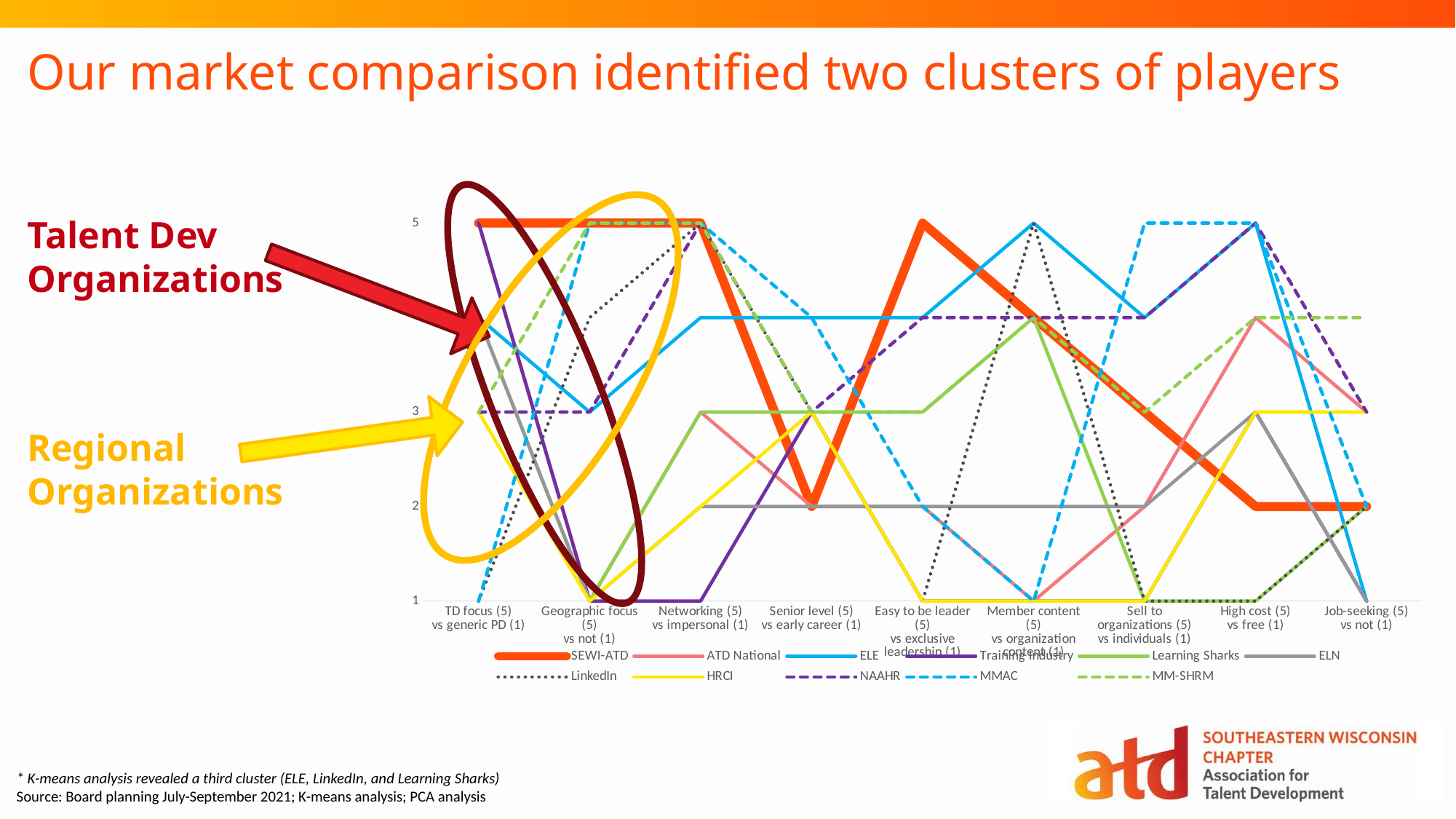
How many series does the chart legend list? 11 What is the value for ELE at 'Job-seeking (5) vs not (1)'? 1 Which series is drawn with the thick orange line in the chart? SEWI-ATD What is the difference between the SEWI-ATD value at 'Easy to be leader (5) vs exclusive leadership (1)' and its value at 'Senior level (5) vs early career (1)'? 3 What kind of chart is shown on the slide? line chart What is the value for ELE at 'Member content (5) vs organization content (1)'? 5 What is the title of the slide containing the chart? Our market comparison identified two clusters of players How many categories are shown along the x axis of the chart? 9 Which is larger at 'Job-seeking (5) vs not (1)': the value for SEWI-ATD or the value for ELE? SEWI-ATD What is the value for SEWI-ATD at 'Senior level (5) vs early career (1)'? 2 What is the value for SEWI-ATD at 'TD focus (5) vs generic PD (1)'? 5 What is the value for SEWI-ATD at 'Job-seeking (5) vs not (1)'? 2